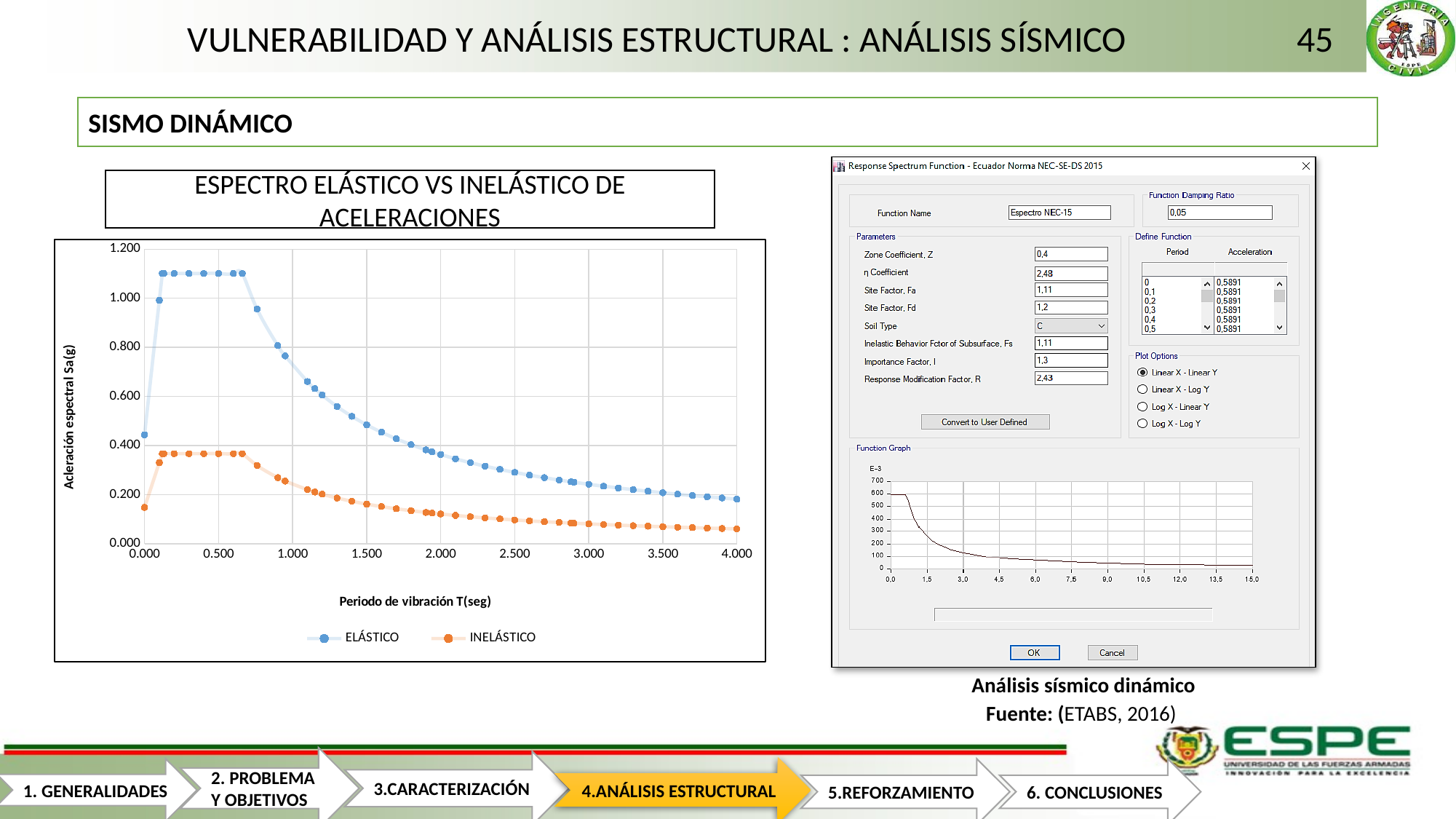
In the chart ESPECTRO ELÁSTICO VS INELÁSTICO DE ACELERACIONES, which series reaches the highest value? ELÁSTICO What kind of chart is ESPECTRO ELÁSTICO VS INELÁSTICO DE ACELERACIONES? Line chart with markers In the chart ESPECTRO ELÁSTICO VS INELÁSTICO DE ACELERACIONES, is the ELÁSTICO value at a period of 1.000 greater or less than 0.600? greater In the chart ESPECTRO ELÁSTICO VS INELÁSTICO DE ACELERACIONES, how many series does the legend list? 2 In the chart ESPECTRO ELÁSTICO VS INELÁSTICO DE ACELERACIONES, what is the label of the x axis? Periodo de vibración T(seg) In the chart ESPECTRO ELÁSTICO VS INELÁSTICO DE ACELERACIONES, is the ELÁSTICO value at a period of 0.500 greater or less than 1.000? greater In the chart ESPECTRO ELÁSTICO VS INELÁSTICO DE ACELERACIONES, do the ELÁSTICO values rise or fall as the period increases from 1.000 to 4.000? fall In the chart ESPECTRO ELÁSTICO VS INELÁSTICO DE ACELERACIONES, is the INELÁSTICO value at a period of 4.000 greater or less than 0.100? less In the chart ESPECTRO ELÁSTICO VS INELÁSTICO DE ACELERACIONES, which series has the larger value at a period of 2.000, ELÁSTICO or INELÁSTICO? ELÁSTICO What is the title of the chart on the left of the slide? ESPECTRO ELÁSTICO VS INELÁSTICO DE ACELERACIONES In the chart ESPECTRO ELÁSTICO VS INELÁSTICO DE ACELERACIONES, what are the names of the two series in the legend? ELÁSTICO and INELÁSTICO